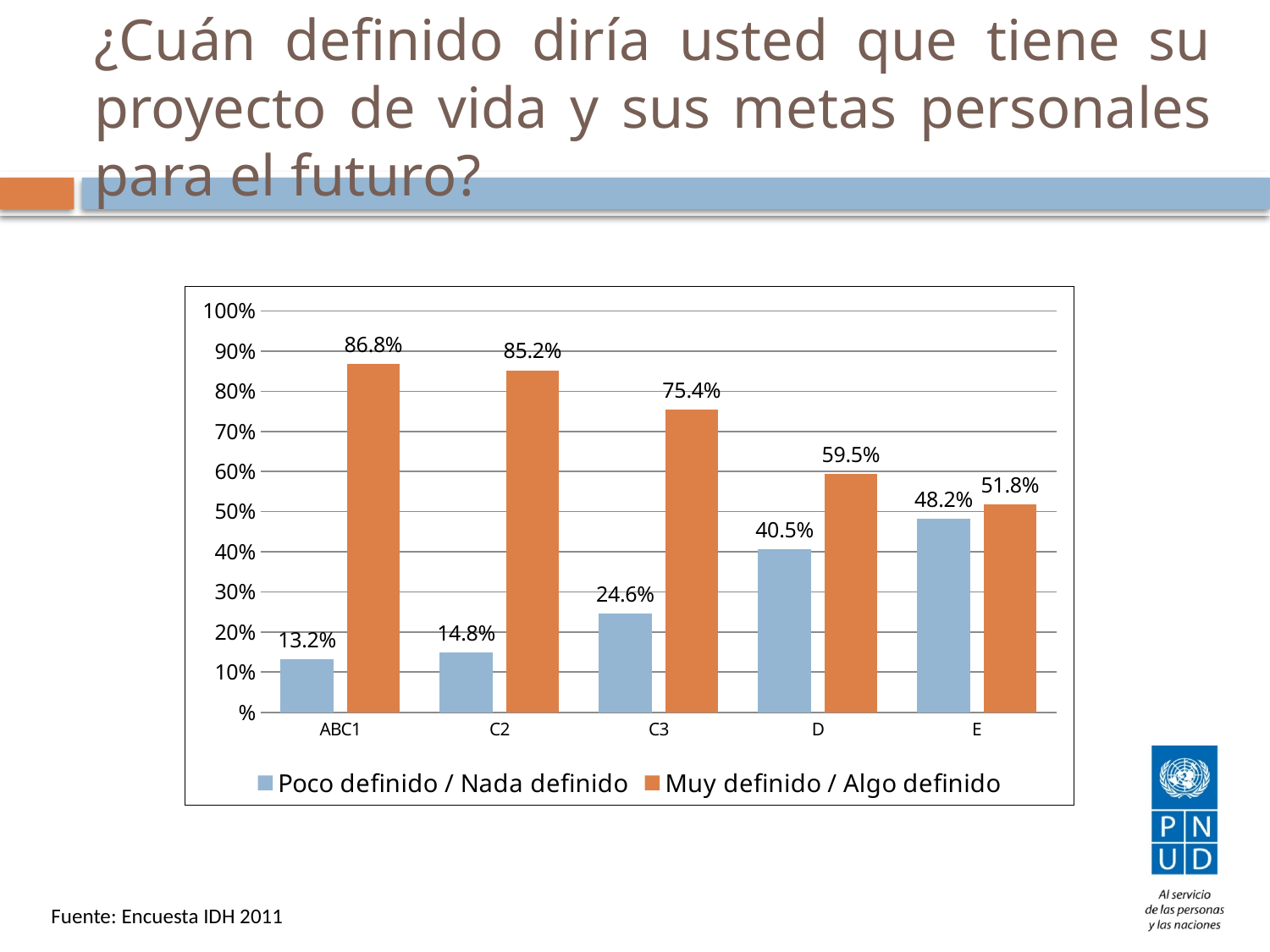
Which category has the highest value for 'Muy definido / Algo definido'? ABC1 What is the difference between the 'Muy definido / Algo definido' and 'Poco definido / Nada definido' values in the E category? 3.6% What is the value for 'Poco definido / Nada definido' in the C3 category? 24.6% What is the value for 'Poco definido / Nada definido' in the D category? 40.5% What kind of chart is shown on the slide? Bar chart Do the 'Muy definido / Algo definido' values rise or fall from ABC1 to E? Fall What colour are the bars for 'Muy definido / Algo definido'? Orange How many categories are shown on the x axis? 5 How many series does the legend list? 2 Which is larger: 'Poco definido / Nada definido' for C2 or for C3? C3 Which category has the lowest value for 'Poco definido / Nada definido'? ABC1 What is the value for 'Muy definido / Algo definido' in the ABC1 category? 86.8%